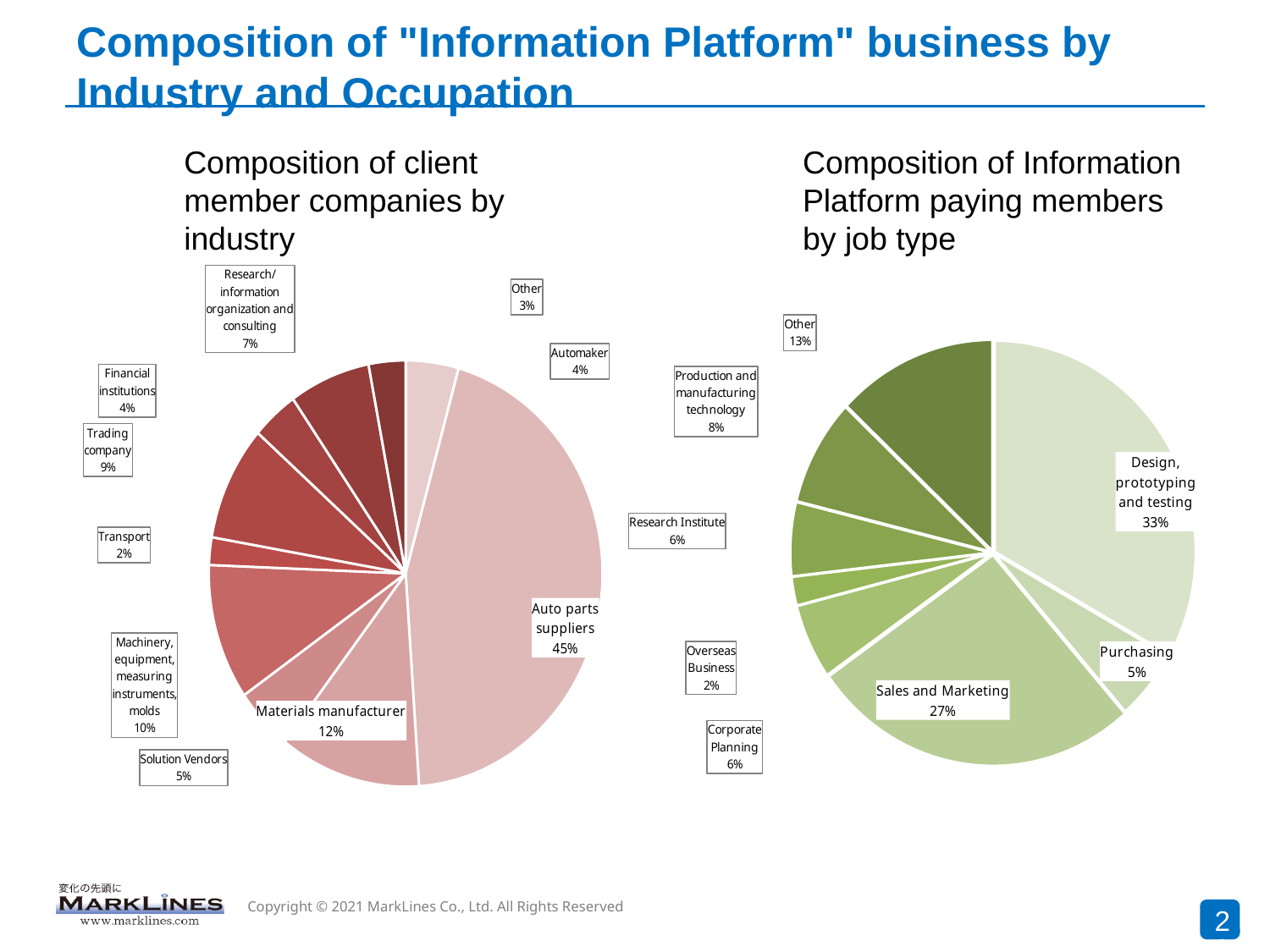
In the 'Composition of Information Platform paying members by job type' chart, which job type has the largest share? Design, prototyping and testing In the 'Composition of Information Platform paying members by job type' chart, what share does Sales and Marketing have? 27% In the 'Composition of Information Platform paying members by job type' chart, which is larger: Purchasing or Production and manufacturing technology? Production and manufacturing technology In the 'Composition of Information Platform paying members by job type' chart, how many slices does the pie have? 8 In the 'Composition of client member companies by industry' chart, what is the difference between the Trading company share and the Financial institutions share? 5% In the 'Composition of client member companies by industry' chart, what share do Auto parts suppliers have? 45% In the 'Composition of client member companies by industry' chart, which industry has the largest share? Auto parts suppliers In the 'Composition of client member companies by industry' chart, which industry has the smallest share? Transport In the 'Composition of client member companies by industry' chart, what share does Materials manufacturer have? 12% In the 'Composition of client member companies by industry' chart, how many slices does the pie have? 10 What type of chart is used on the right side of the slide? Pie chart In the 'Composition of Information Platform paying members by job type' chart, which job type has the smallest share? Overseas Business